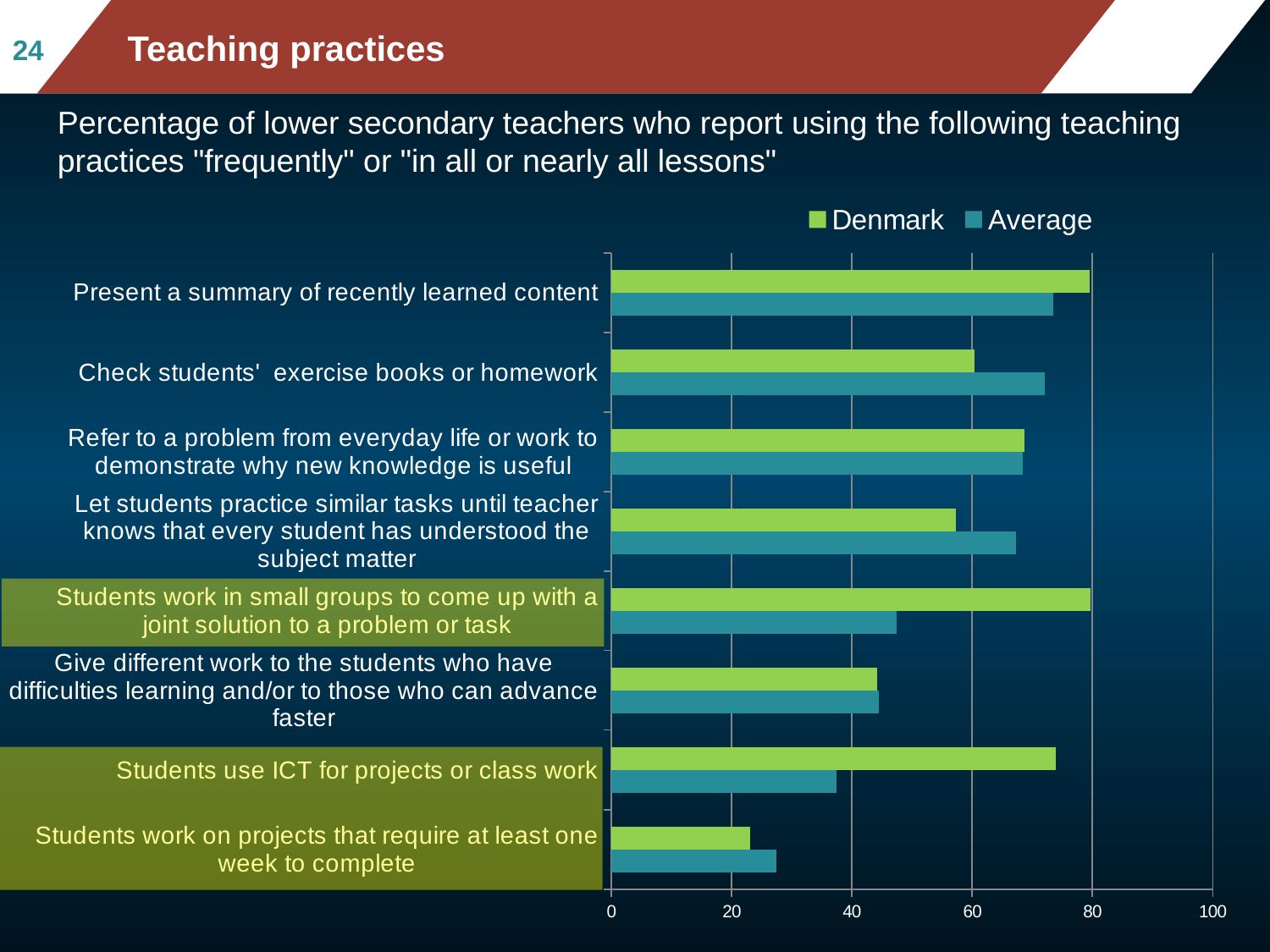
For "Let students practice similar tasks until teacher knows that every student has understood the subject matter", which is larger: Denmark or Average? Average For "Students work in small groups to come up with a joint solution to a problem or task", which is larger: Denmark or Average? Denmark For "Check students' exercise books or homework", which is larger: Denmark or Average? Average How many series does the legend list? 2 Which teaching practice has the lowest value for Denmark? Students work on projects that require at least one week to complete Is the Average value for "Students use ICT for projects or class work" greater or less than 40? less How many teaching practices (categories) are plotted on the chart? 8 Which series are listed in the legend? Denmark and Average Is the Average value for "Students work in small groups to come up with a joint solution to a problem or task" greater or less than 60? less What kind of chart is shown on the slide? bar chart Is the Denmark value for "Students use ICT for projects or class work" greater or less than 60? greater Which teaching practice has the lowest value for Average? Students work on projects that require at least one week to complete